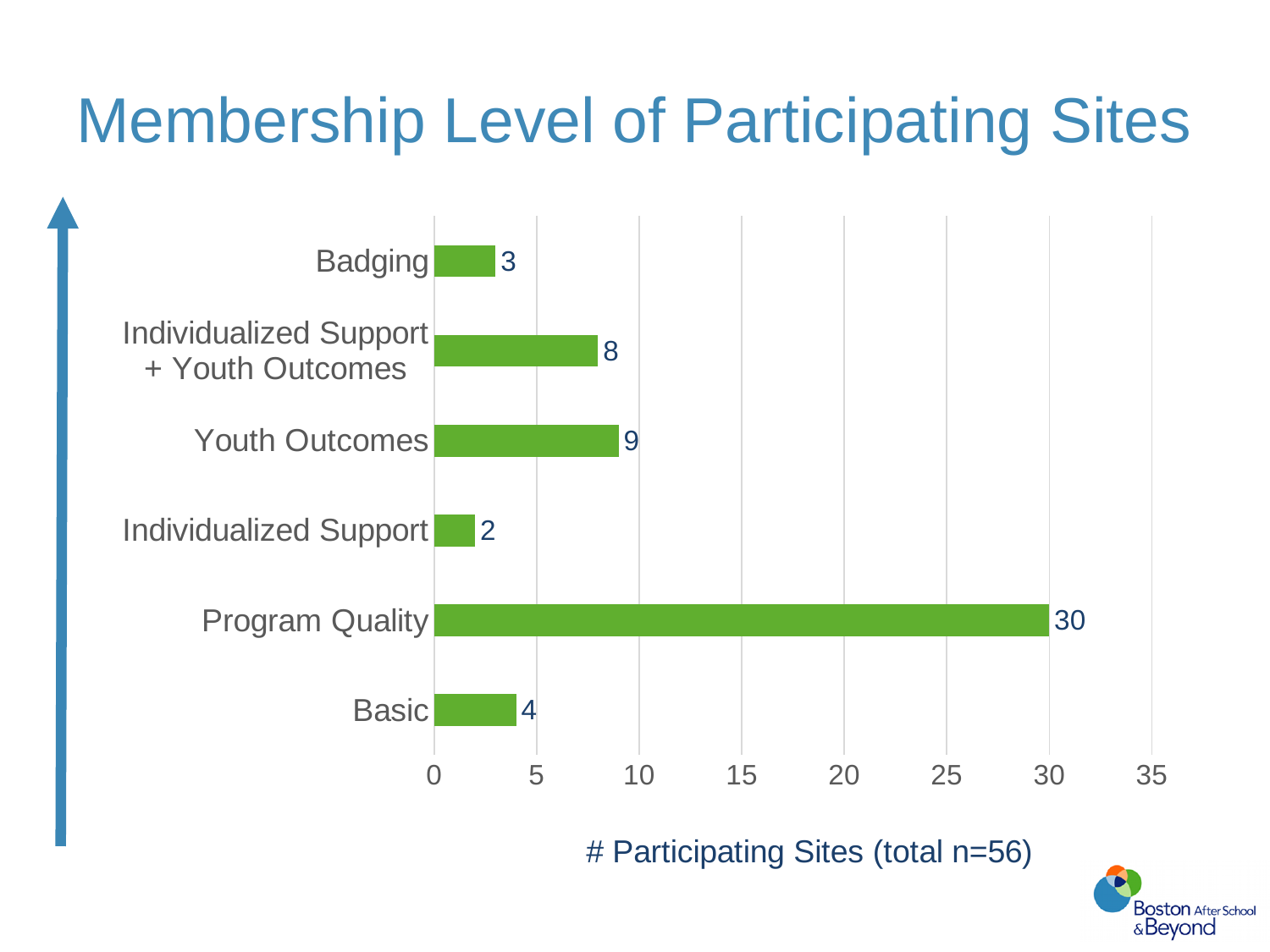
What type of chart is shown on the slide? Bar chart How many participating sites are at the Individualized Support + Youth Outcomes level? 8 What is the difference in participating sites between Program Quality and Youth Outcomes? 21 Which has more participating sites, Basic or Badging? Basic How many membership levels are shown in the chart? 6 Is the value for Program Quality greater or less than 25? greater Which membership level has the lowest number of participating sites? Individualized Support Which membership level has the highest number of participating sites? Program Quality What is the label of the horizontal axis? # Participating Sites (total n=56) What is the title of the chart on the slide? Membership Level of Participating Sites What is the number of participating sites for Badging? 3 How many participating sites are at the Program Quality membership level? 30